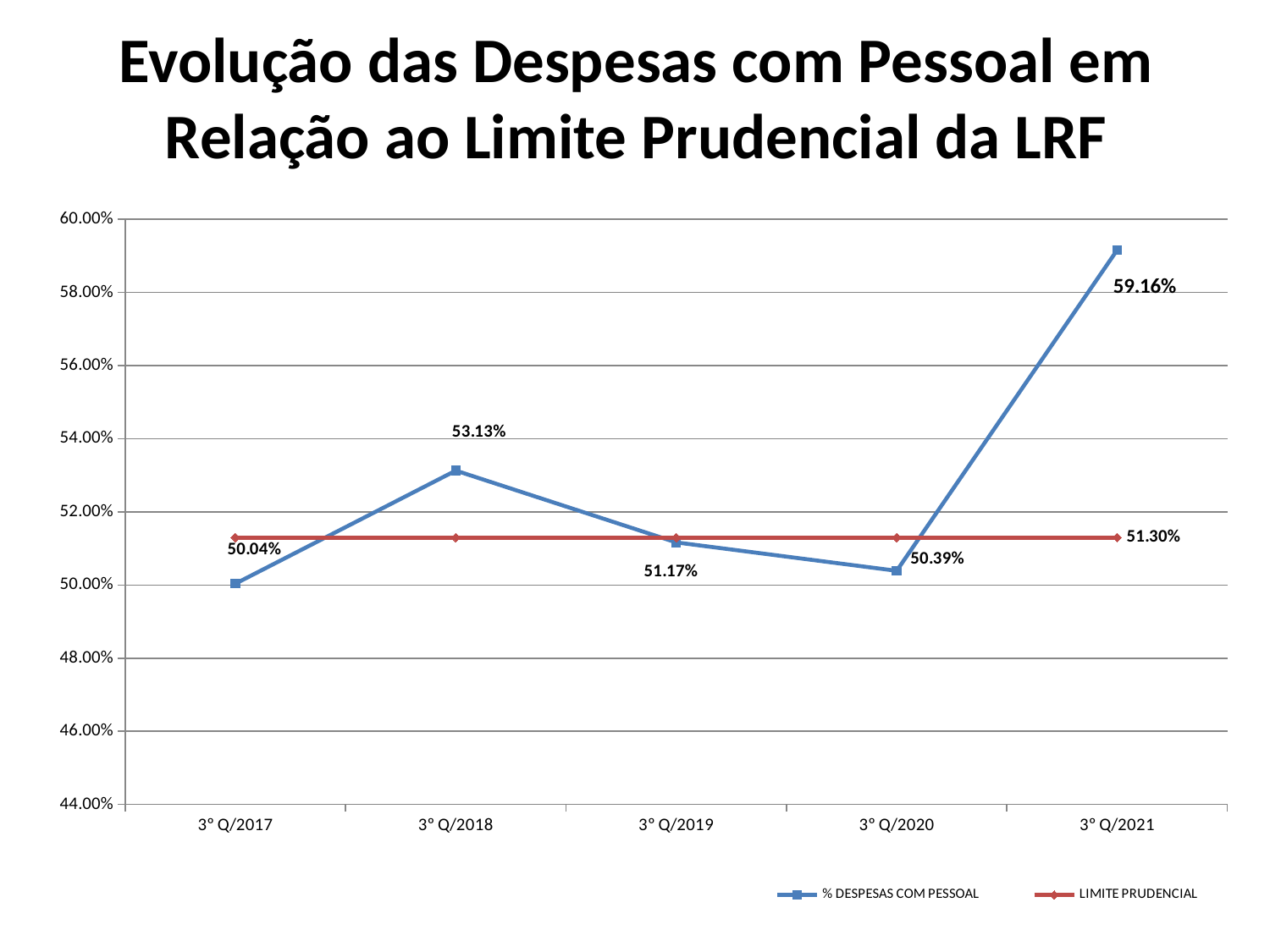
What is the value of % DESPESAS COM PESSOAL for 3° Q/2021? 59.16% In which period is % DESPESAS COM PESSOAL lowest? 3° Q/2017 What is the difference between % DESPESAS COM PESSOAL in 3° Q/2021 and 3° Q/2020? 8.77 percentage points Is the value of % DESPESAS COM PESSOAL for 3° Q/2021 greater or less than 58.00%? greater What is the value of % DESPESAS COM PESSOAL for 3° Q/2017? 50.04% What is the value of the LIMITE PRUDENCIAL line? 51.30% In which period is % DESPESAS COM PESSOAL highest? 3° Q/2021 How many series does the legend list? 2 By how much does % DESPESAS COM PESSOAL in 3° Q/2021 exceed the LIMITE PRUDENCIAL? 7.86 percentage points How many periods are shown on the x axis? 5 Which is larger, % DESPESAS COM PESSOAL in 3° Q/2018 or in 3° Q/2020? 3° Q/2018 What kind of chart is shown on the slide? line chart